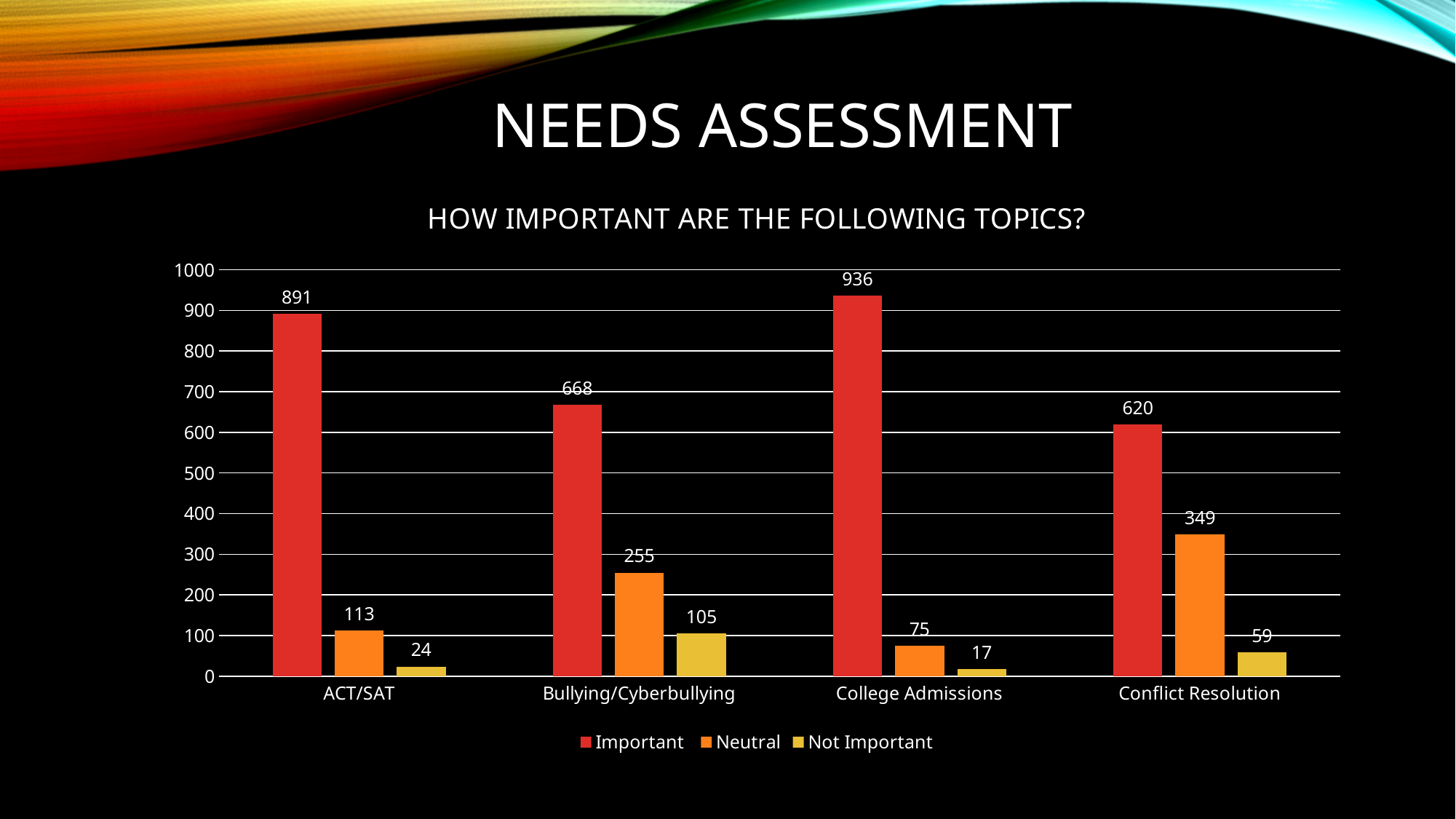
Which topic has the lowest Not Important value? College Admissions What is the Important value for College Admissions? 936 What kind of chart is shown? bar chart Which is larger: the Neutral value for Bullying/Cyberbullying or the Neutral value for ACT/SAT? Bullying/Cyberbullying What is the title of the chart? HOW IMPORTANT ARE THE FOLLOWING TOPICS? What is the difference between the Important values for ACT/SAT and Bullying/Cyberbullying? 223 Is the Important value for Conflict Resolution greater or less than 700? less How many series does the legend list? 3 Which topic has the highest Important value? College Admissions How many topics are shown on the x axis? 4 What is the Not Important value for ACT/SAT? 24 What is the Neutral value for Conflict Resolution? 349